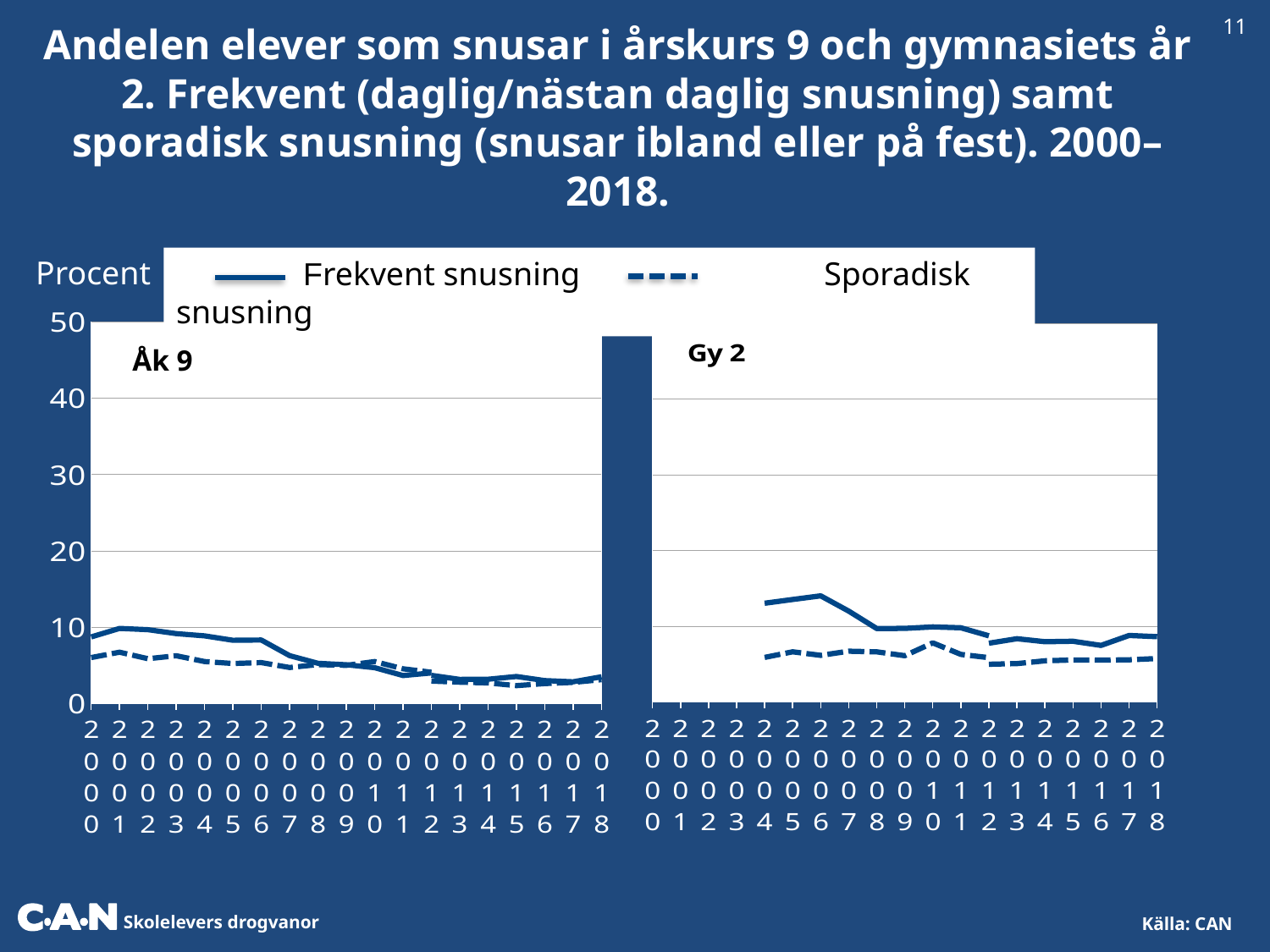
In the Åk 9 panel, does Frekvent snusning rise or fall from 2000 to 2018? fall In the Gy 2 panel, in which year does Frekvent snusning reach its highest value? 2006 What kind of chart is shown on the slide? line chart How many series does the legend list? 2 In the Gy 2 panel, which series has the higher value in 2006, Frekvent snusning or Sporadisk snusning? Frekvent snusning What are the labels of the two panels of the chart? Åk 9 and Gy 2 In the Gy 2 panel, is the value for Frekvent snusning in 2006 greater or less than 10? greater How many years are shown on the x axis of the Åk 9 panel? 19 Which panel shows the higher value for Frekvent snusning in 2018, Åk 9 or Gy 2? Gy 2 Which two series are listed in the legend? Frekvent snusning and Sporadisk snusning In the Åk 9 panel, is the value for Frekvent snusning in 2018 greater or less than 10? less In the Gy 2 panel, is the value for Sporadisk snusning in 2018 greater or less than 10? less